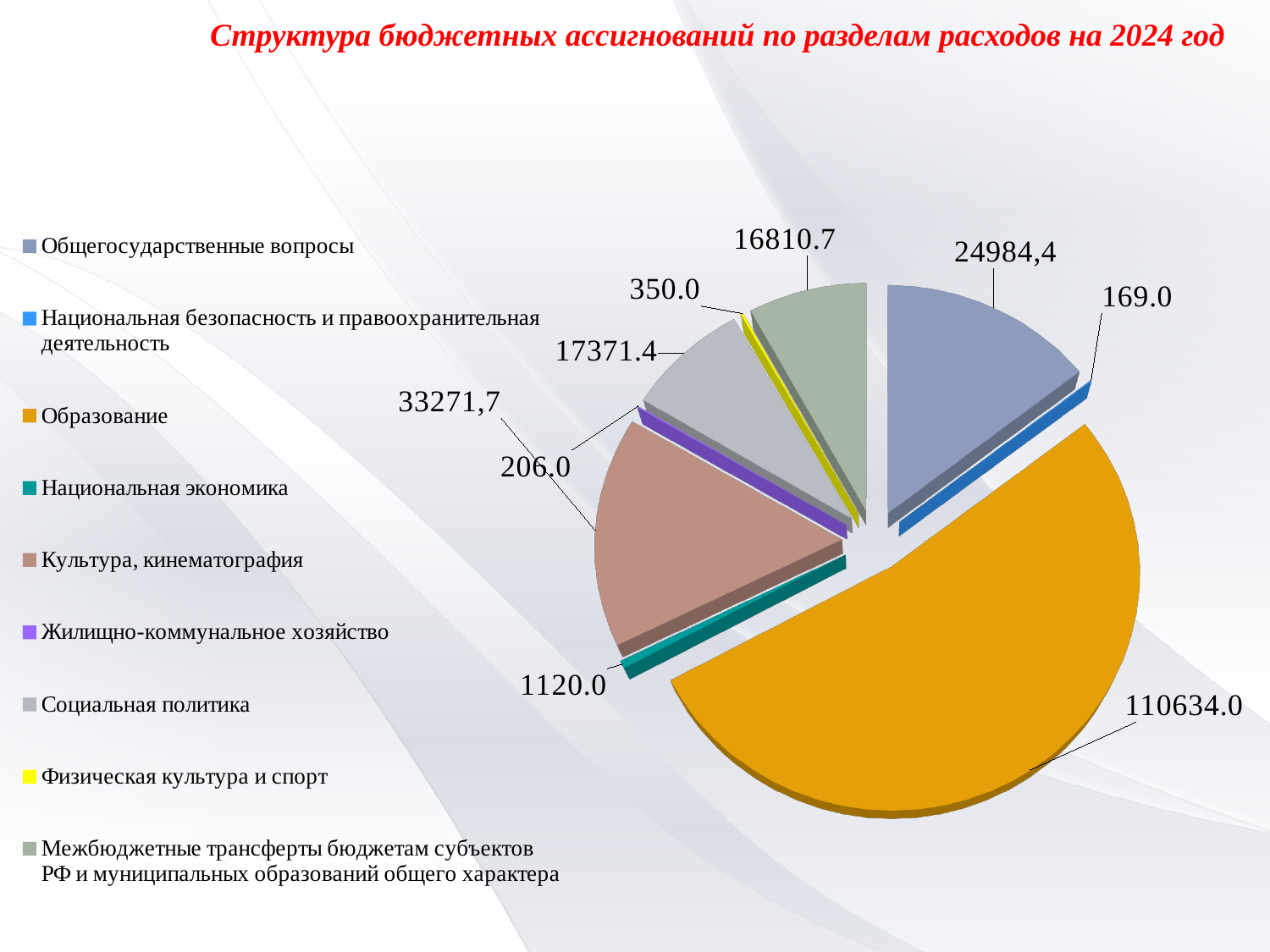
Which category has the smallest value? Национальная безопасность и правоохранительная деятельность What is the value for Национальная безопасность и правоохранительная деятельность? 169.0 What is the value for Образование? 110634.0 What is the value for Общегосударственные вопросы? 24984,4 What is the value for Социальная политика? 17371.4 Which is larger: Социальная политика or Межбюджетные трансферты бюджетам субъектов РФ и муниципальных образований общего характера? Социальная политика What is the difference between the values for Национальная экономика and Физическая культура и спорт? 770.0 Which category has the largest slice of the pie? Образование What type of chart is shown on the slide? Pie chart How many categories does the legend list? 9 What is the value for Культура, кинематография? 33271,7 What is the title of the chart? Структура бюджетных ассигнований по разделам расходов на 2024 год